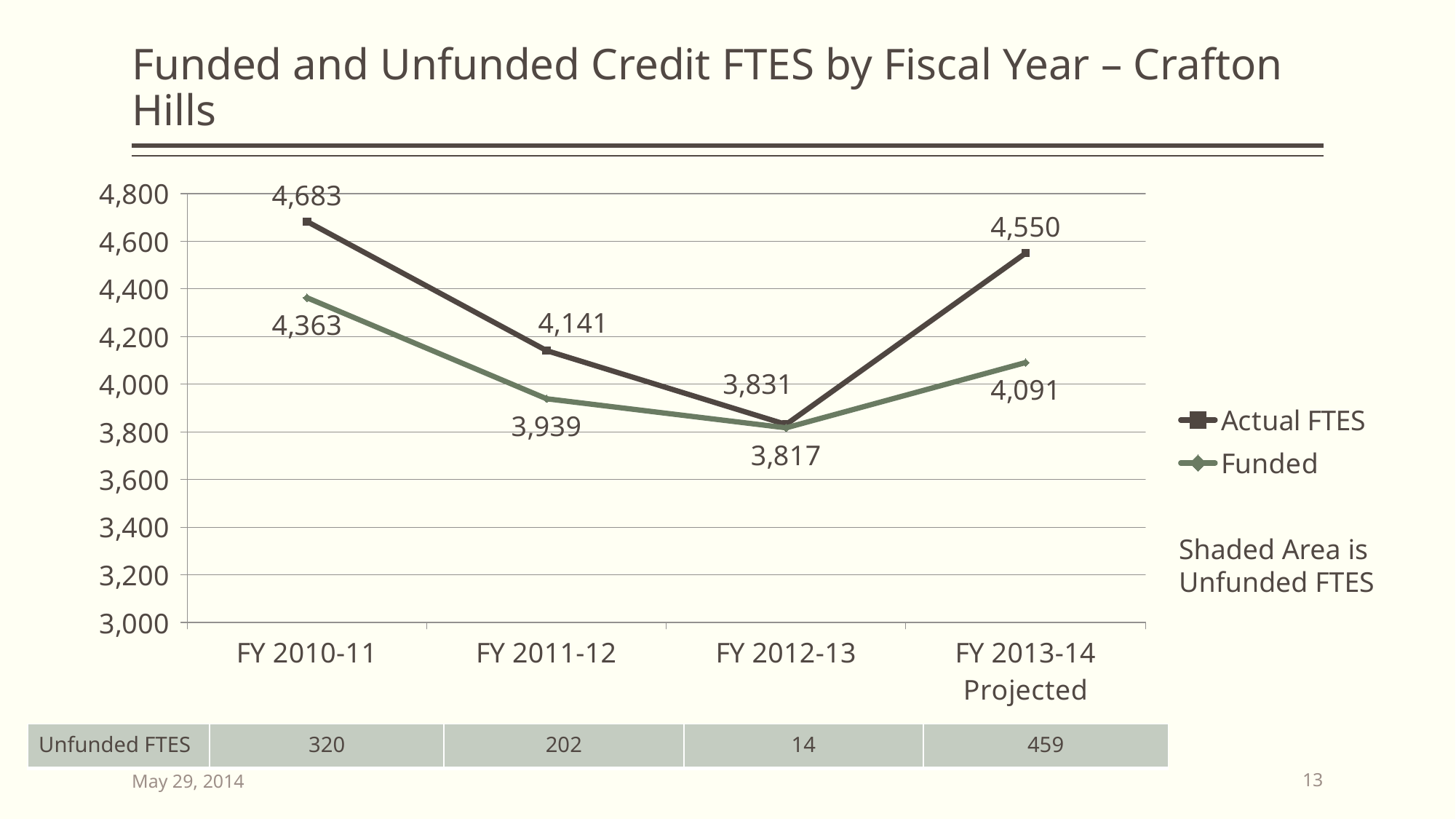
What is the Funded value for FY 2012-13? 3,817 What is the difference between the Actual FTES values for FY 2013-14 Projected and FY 2012-13? 719 What is the Actual FTES value for FY 2010-11? 4,683 What is the difference between Actual FTES and Funded in FY 2010-11? 320 In which fiscal year is the Actual FTES value lowest? FY 2012-13 How many fiscal years are plotted on the x axis? 4 What is the Actual FTES value for FY 2013-14 Projected? 4,550 Which is larger in FY 2011-12, Actual FTES or Funded? Actual FTES What is the Funded value for FY 2011-12? 3,939 What kind of chart is shown on the slide? Line chart In which fiscal year is the Funded value highest? FY 2010-11 How many series does the legend list? 2